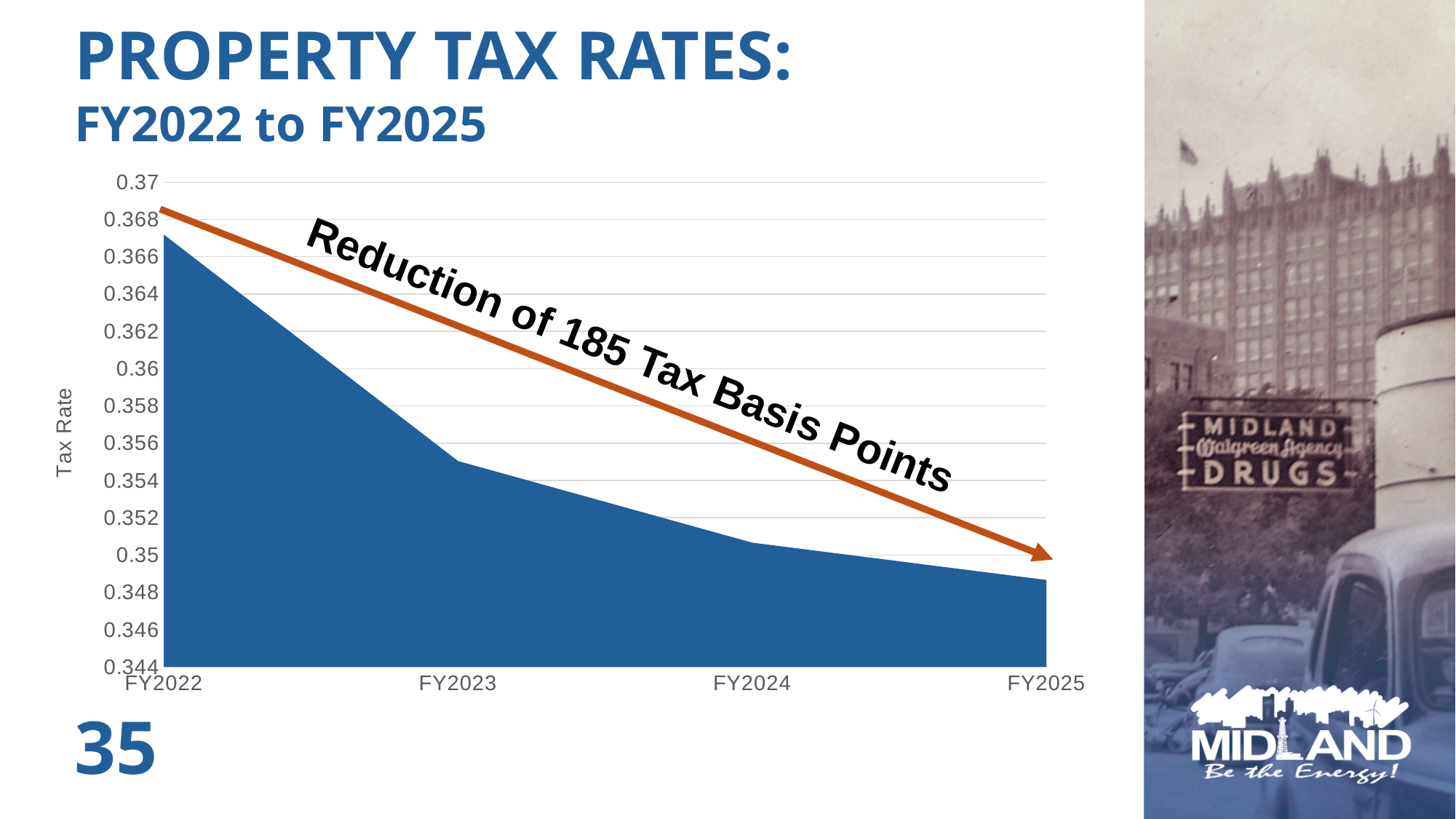
Which fiscal year has the highest tax rate? FY2022 Is the tax rate for FY2022 greater or less than 0.36? greater Do the tax rate values rise or fall from FY2022 to FY2025? Fall Is the tax rate for FY2025 greater or less than 0.35? less What is the label on the vertical axis of the chart? Tax Rate What does the annotation along the arrow on the chart say? Reduction of 185 Tax Basis Points Which has the larger tax rate, FY2023 or FY2024? FY2023 Which fiscal year has the lowest tax rate? FY2025 Is the tax rate for FY2023 greater or less than 0.358? less What kind of chart is shown on the slide? Area chart How many fiscal years are plotted on the x axis? 4